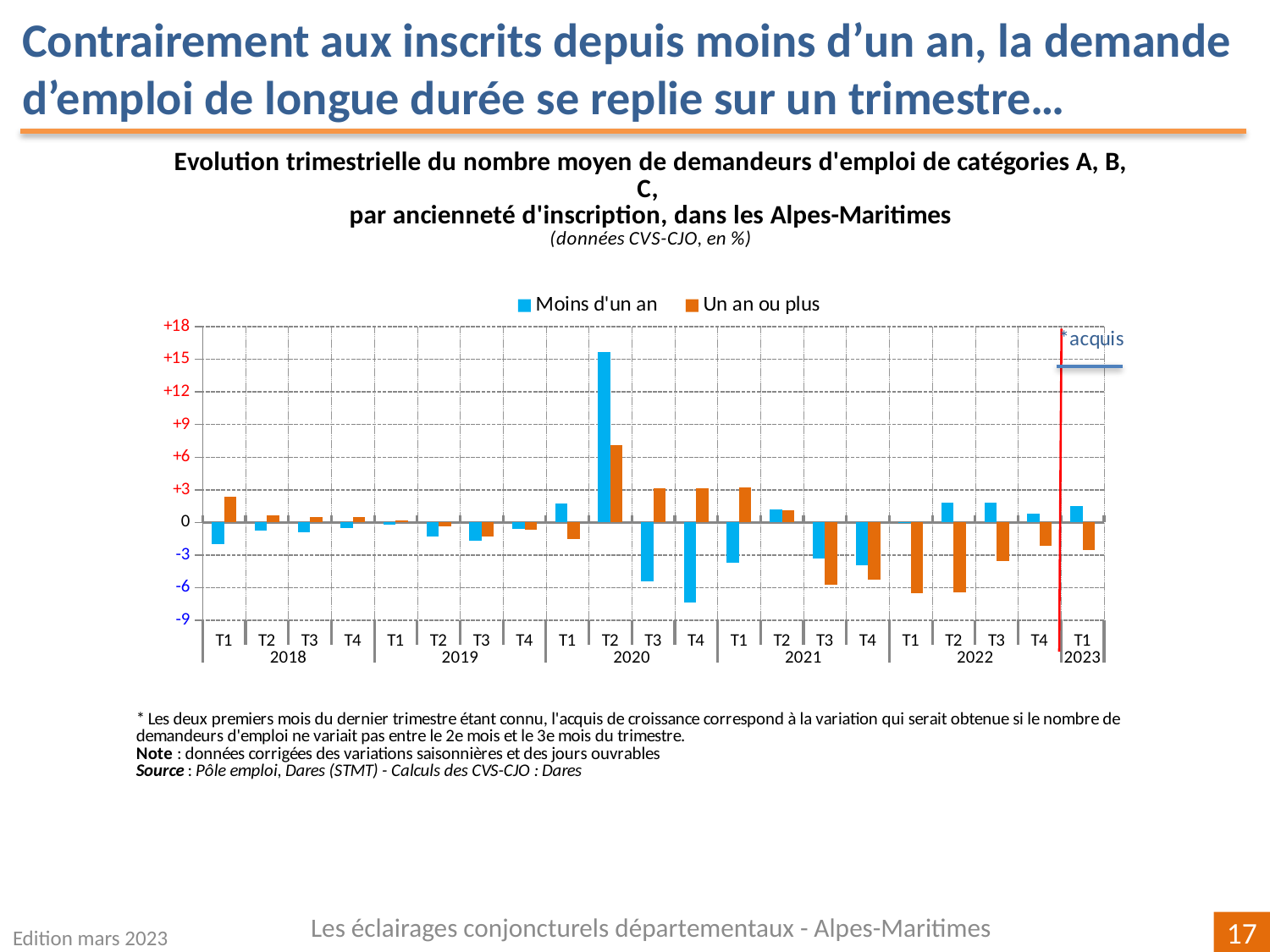
In which quarter is the value for 'Moins d'un an' highest? T2 2020 In T1 2023, which series has the larger value, 'Moins d'un an' or 'Un an ou plus'? Moins d'un an Which colour represents the 'Un an ou plus' series? Orange In which quarter is the value for 'Moins d'un an' lowest? T4 2020 Is the value for 'Un an ou plus' in T3 2021 greater or less than -3? less Is the value for 'Moins d'un an' in T2 2020 greater or less than +12? greater In which quarter is the value for 'Un an ou plus' highest? T2 2020 What kind of chart is shown on the slide? Bar chart Is the value for 'Moins d'un an' in T4 2020 greater or less than -6? less In T3 2021, which series has the larger value, 'Moins d'un an' or 'Un an ou plus'? Moins d'un an How many quarters are plotted along the x axis? 21 How many series does the legend list? 2